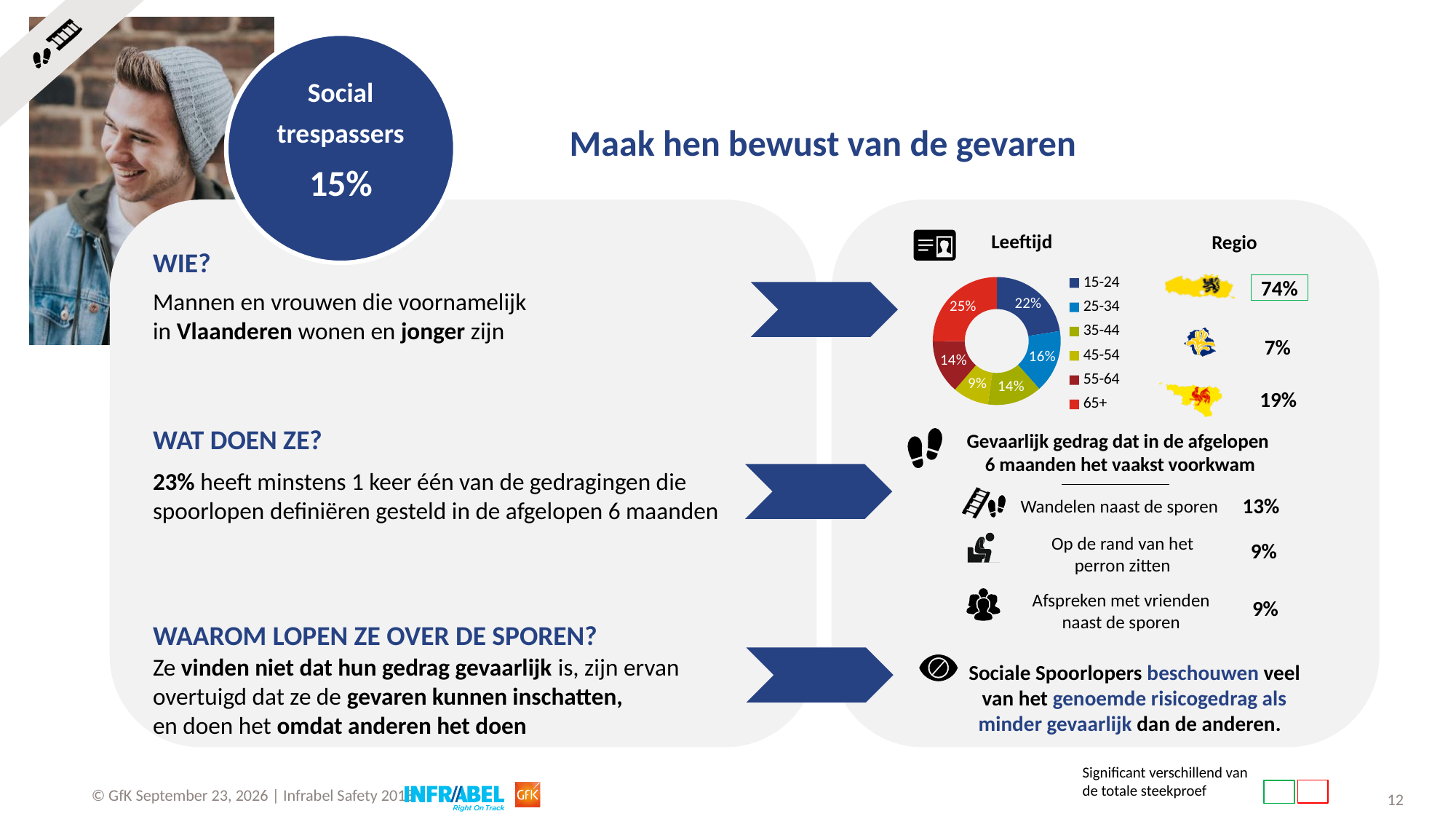
In the Leeftijd chart, which age group has the largest share? 65+ In the Leeftijd chart, what percentage is shown for the 65+ age group? 25% In the Leeftijd chart, what percentage is shown for the 25-34 age group? 16% What type of chart is the Leeftijd chart? Pie chart (donut) How many age groups are shown in the Leeftijd chart? 6 In the Leeftijd chart, which age group has the smallest share? 45-54 In the Leeftijd chart, which is larger: the share for 15-24 or the share for 25-34? 15-24 In the Leeftijd chart, what percentage is shown for the 15-24 age group? 22% In the Leeftijd chart, what is the difference between the 65+ share and the 15-24 share? 3% How many entries does the legend of the Leeftijd chart list? 6 In the Leeftijd chart, what percentage is shown for the 45-54 age group? 9% In the Leeftijd chart, what is the difference between the 15-24 share and the 45-54 share? 13%